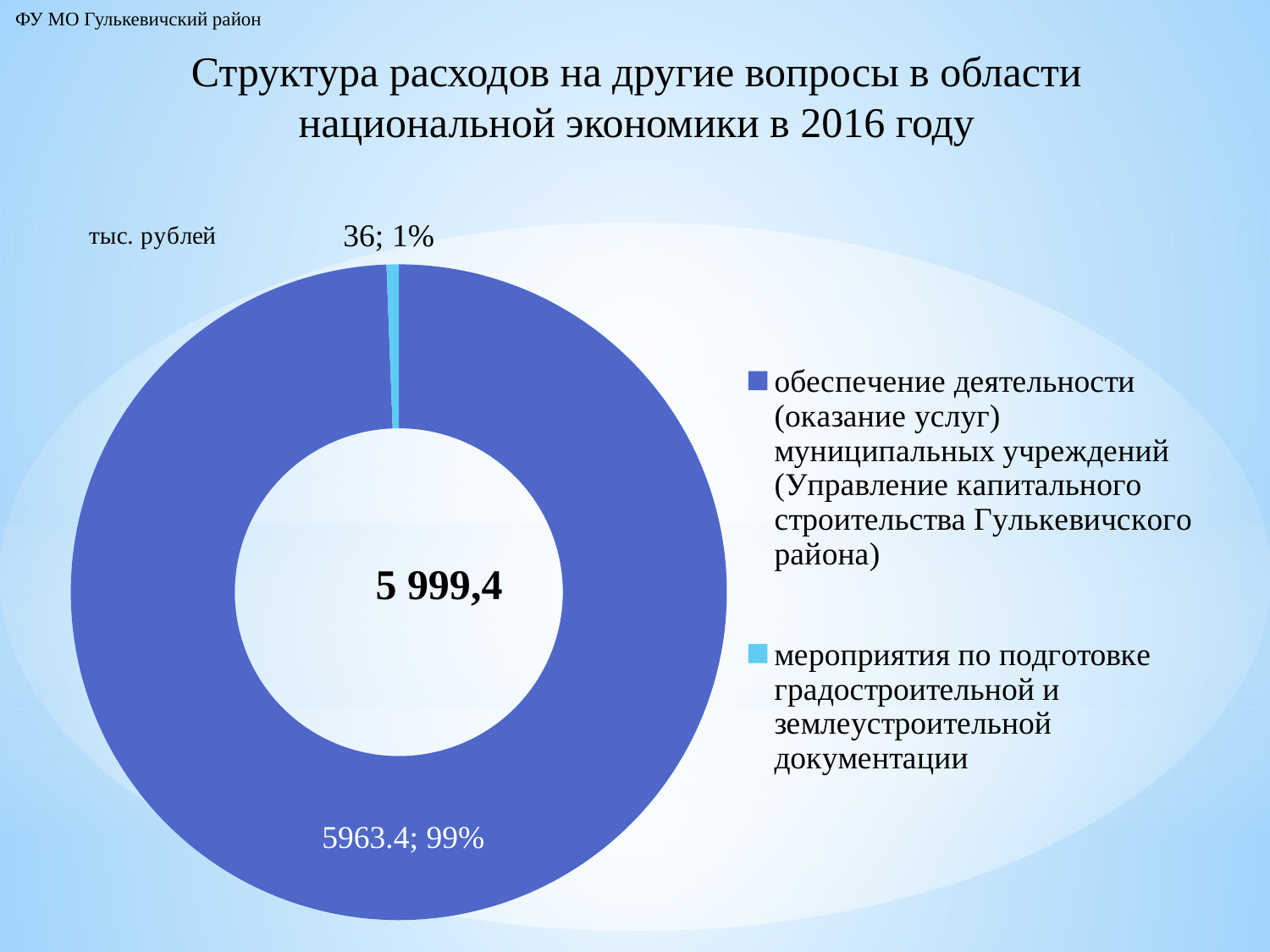
What share of the chart does 'обеспечение деятельности (оказание услуг) муниципальных учреждений' represent? 99% What is the value for 'мероприятия по подготовке градостроительной и землеустроительной документации'? 36 What kind of chart is shown on the slide? doughnut (pie) chart What share of the chart does 'мероприятия по подготовке градостроительной и землеустроительной документации' represent? 1% Which category has the largest slice? обеспечение деятельности (оказание услуг) муниципальных учреждений (Управление капитального строительства Гулькевичского района) How many entries does the legend list? 2 What unit of measurement is indicated on the slide for the chart values? тыс. рублей What is the difference between the two slice values? 5927.4 What total is shown in the centre of the doughnut? 5 999,4 What is the value for 'обеспечение деятельности (оказание услуг) муниципальных учреждений'? 5963.4 How many slices does the chart have? 2 Which category has the smallest slice? мероприятия по подготовке градостроительной и землеустроительной документации